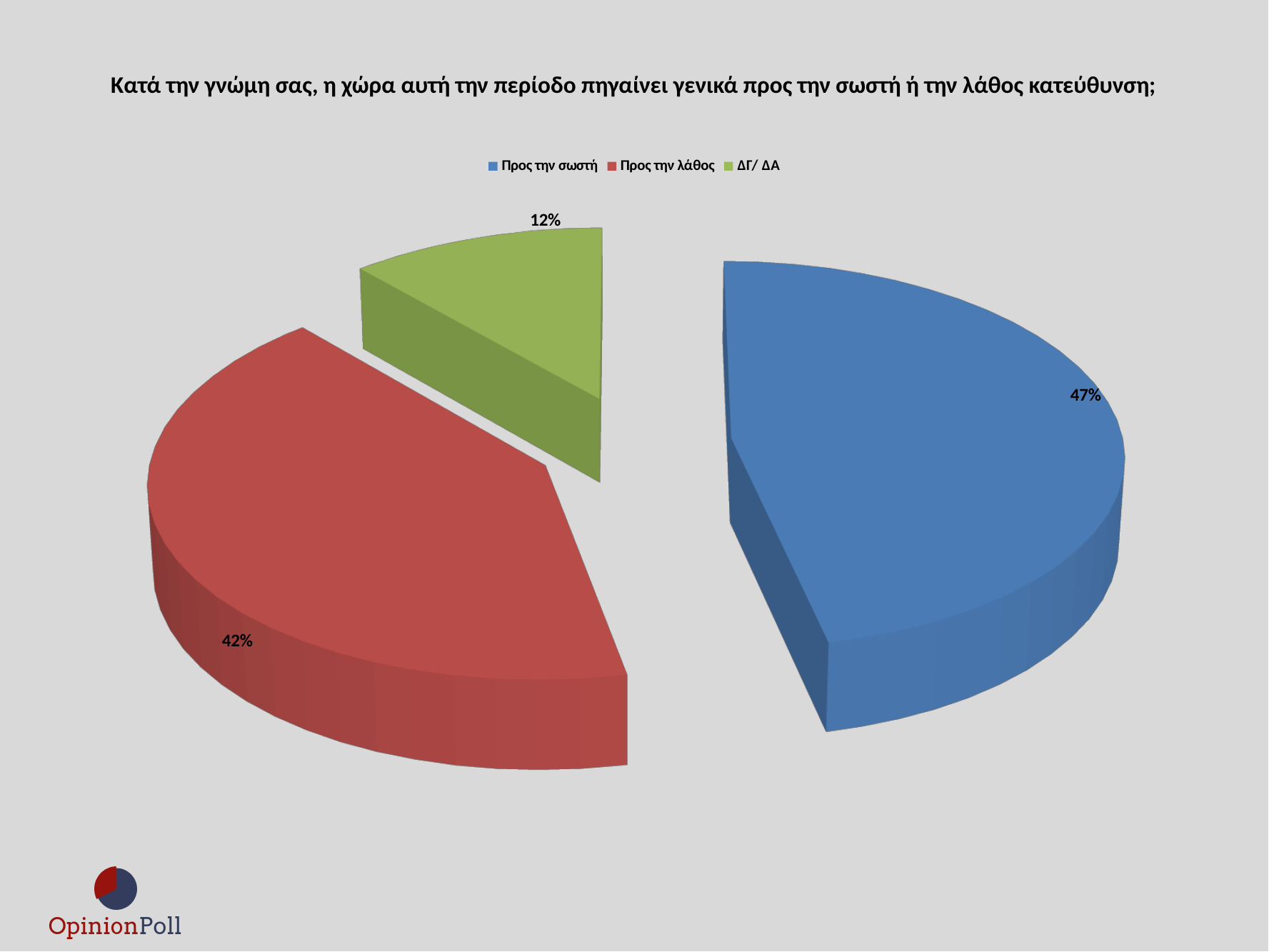
Which response has the smallest share of the pie? ΔΓ/ ΔΑ How many slices does the pie chart have? 3 What is the difference in percentage points between 'Προς την σωστή' and 'Προς την λάθος'? 5 What colour is the slice for 'ΔΓ/ ΔΑ'? Green What is the difference in percentage points between 'Προς την λάθος' and 'ΔΓ/ ΔΑ'? 30 What kind of chart is shown on the slide? Pie chart What percentage of respondents answered 'Προς την σωστή'? 47% How many entries does the legend list? 3 What percentage of respondents answered 'Προς την λάθος'? 42% What percentage of respondents answered 'ΔΓ/ ΔΑ'? 12% Which is larger, the share for 'Προς την σωστή' or the share for 'Προς την λάθος'? Προς την σωστή Which response has the largest share of the pie? Προς την σωστή